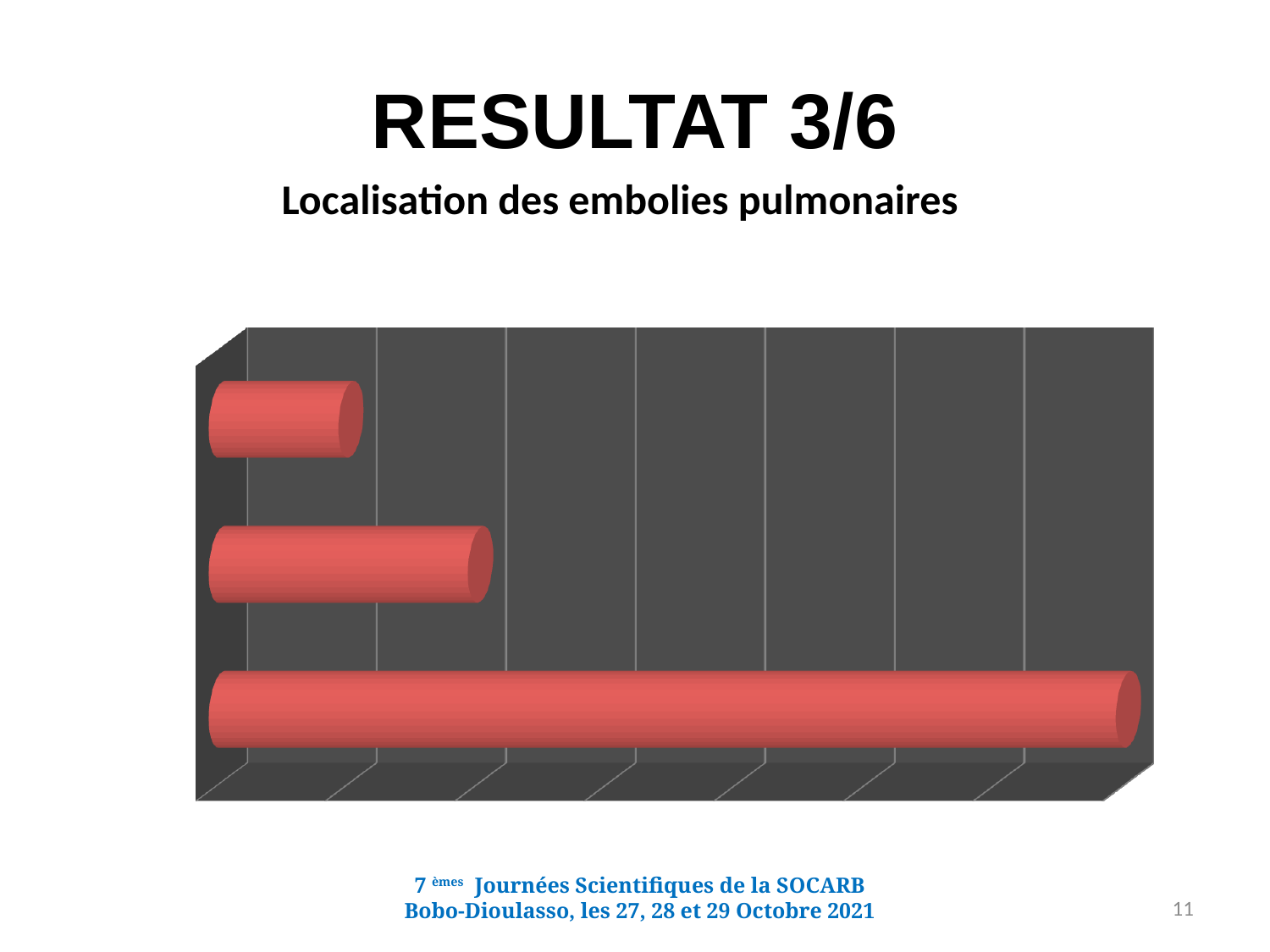
Which bar is the shortest: the top, middle or bottom bar? top Do the bar lengths increase or decrease going from the top bar to the bottom bar? increase What kind of chart is shown on the slide? bar chart Which is longer, the middle bar or the bottom bar? the bottom bar How many bars does the chart contain? 3 Which is longer, the top bar or the middle bar? the middle bar What is the subtitle describing the chart on the slide? Localisation des embolies pulmonaires What colour are the bars in the chart? red Which bar is the longest: the top, middle or bottom bar? bottom